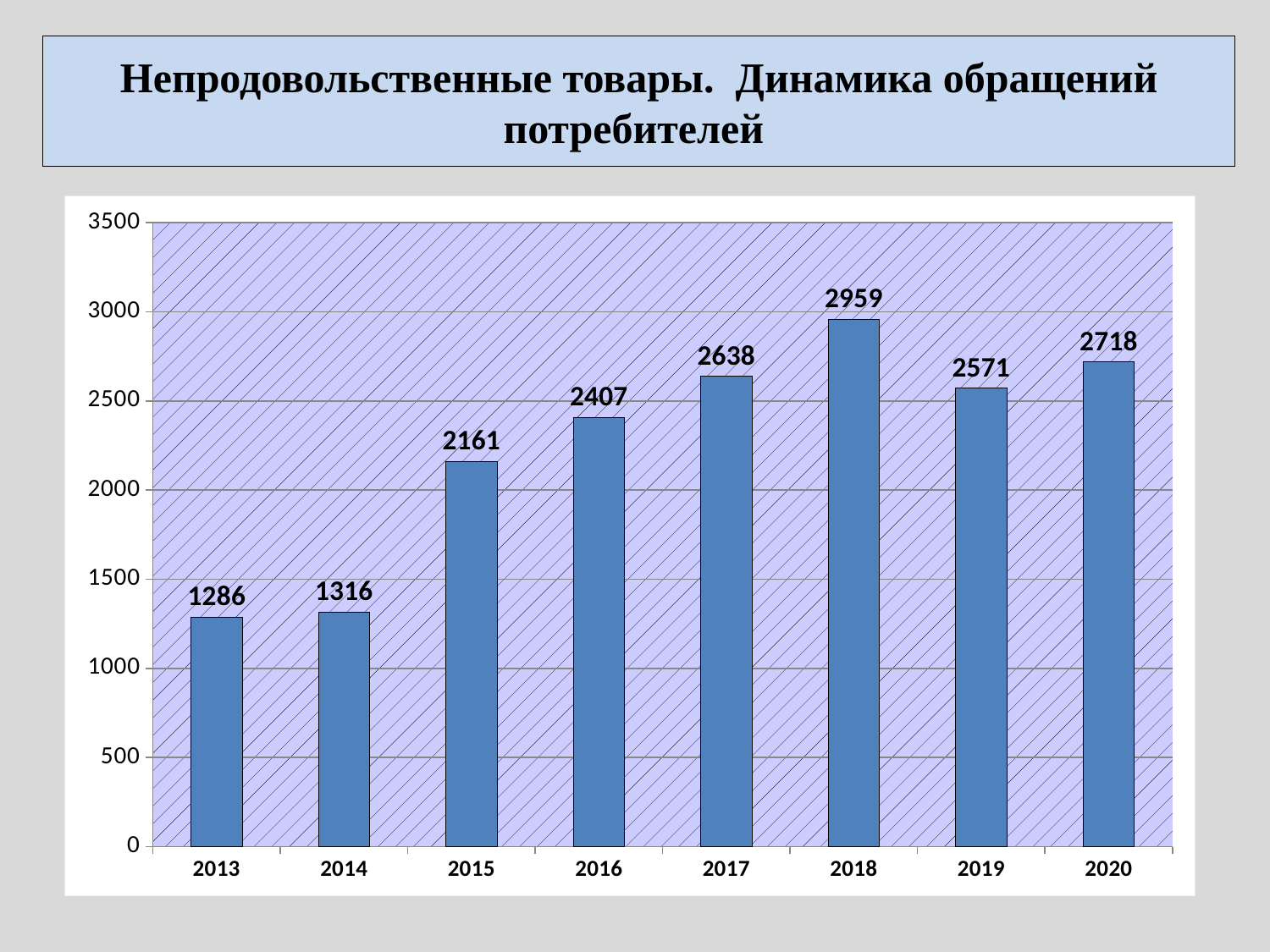
What is the value for 2018? 2959 Do the values rise or fall from 2013 to 2018? rise What is the value for 2013? 1286 How many years are shown on the x axis? 8 Which year has the lowest value? 2013 What is the difference between the values for 2015 and 2014? 845 Which year has the highest value? 2018 What is the difference between the values for 2018 and 2019? 388 What kind of chart is shown on the slide? bar chart Is the value for 2016 greater or less than 2500? less Which is larger, the value for 2017 or the value for 2020? 2020 What is the value for 2020? 2718